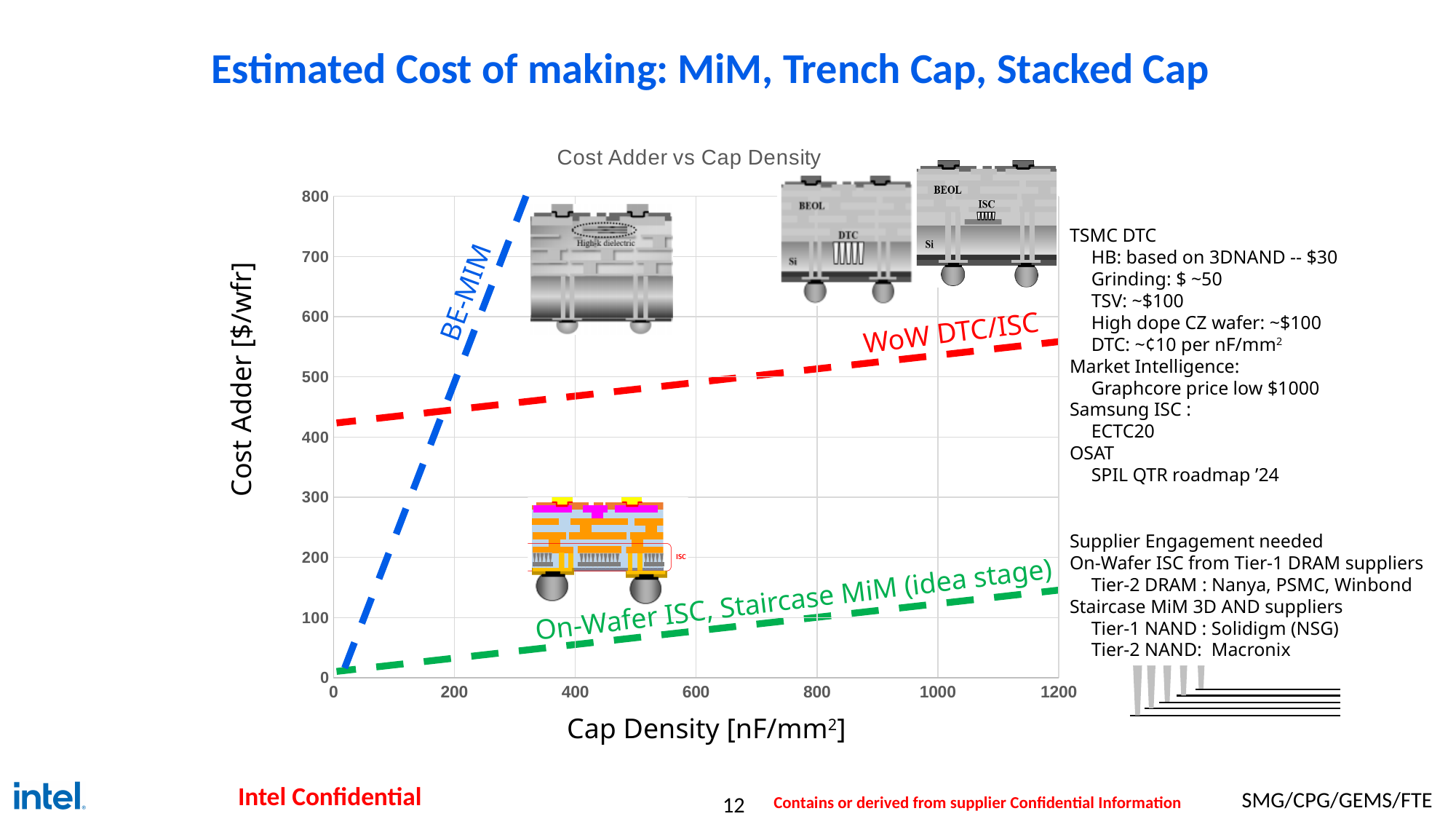
Does the WoW DTC/ISC line rise or fall as cap density increases? rise Is the cost adder for BE-MIM at a cap density of 100 greater or less than 200? greater What is the label of the y axis of the chart? Cost Adder [$/wfr] What kind of chart is shown on the slide? line chart How many lines are plotted on the chart? 3 Is the cost adder for WoW DTC/ISC at a cap density of 1200 greater or less than 500? greater Which line rises most steeply with cap density? BE-MIM What is the title of the chart? Cost Adder vs Cap Density Is the cost adder for On-Wafer ISC, Staircase MiM (idea stage) at a cap density of 1200 greater or less than 200? less Does the On-Wafer ISC, Staircase MiM (idea stage) line rise or fall as cap density increases? rise At a cap density of 600, which line has the higher cost adder: WoW DTC/ISC or On-Wafer ISC, Staircase MiM (idea stage)? WoW DTC/ISC